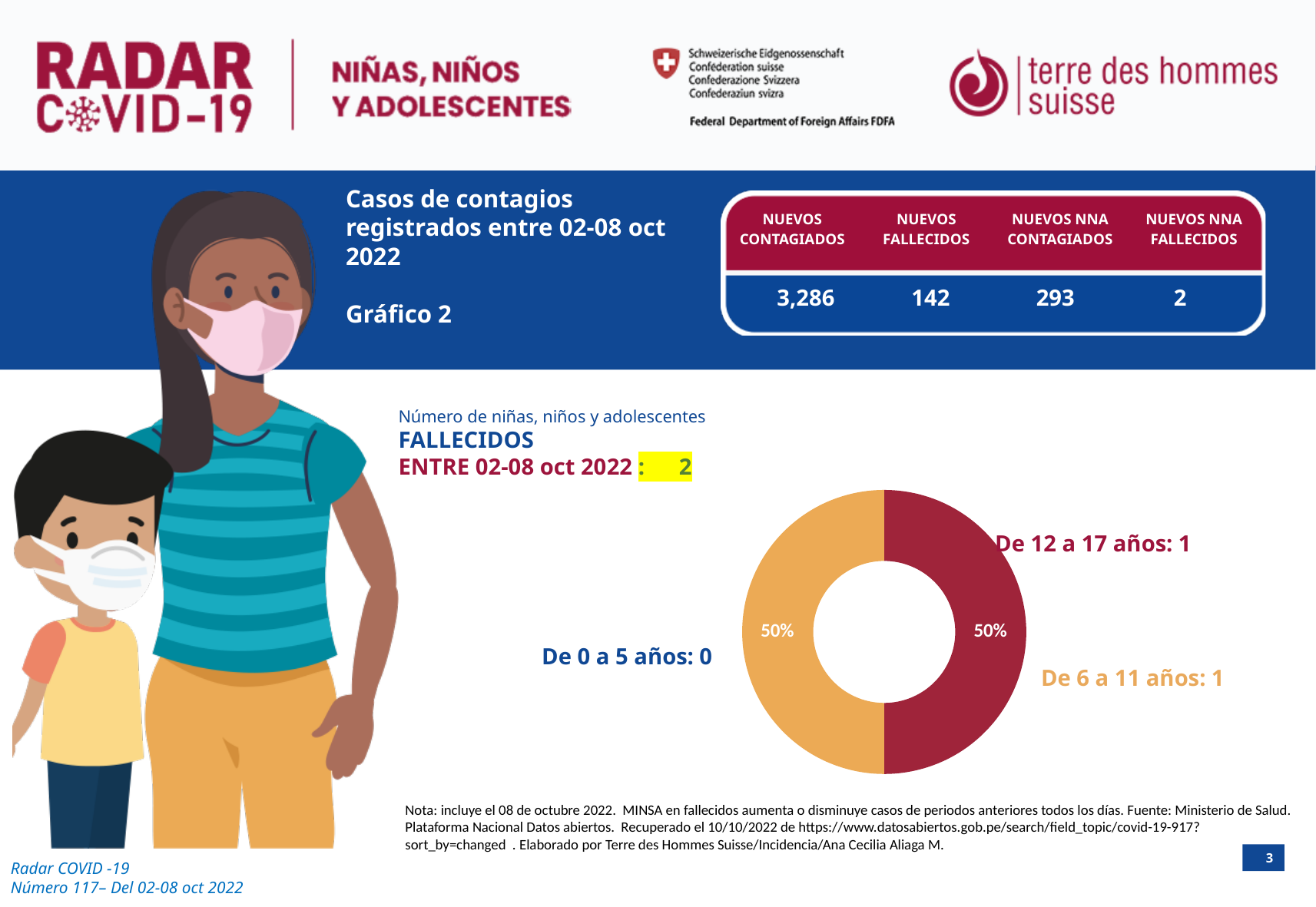
What is the value for 'De 0 a 5 años'? 0 What is the total number of fallecidos shown for the period 02-08 oct 2022? 2 What share of the pie does 'De 6 a 11 años' represent? 50% Which age category has the lowest value? De 0 a 5 años What kind of chart is shown on the slide? Pie chart (donut) What is the value for 'De 12 a 17 años'? 1 What is the value for 'De 6 a 11 años'? 1 Which is larger, the value for 'De 6 a 11 años' or 'De 0 a 5 años'? De 6 a 11 años What share of the pie does 'De 12 a 17 años' represent? 50% What is the difference between the values for 'De 12 a 17 años' and 'De 0 a 5 años'? 1 What colour is the slice for 'De 12 a 17 años'? Red How many age categories are labelled on the chart? 3